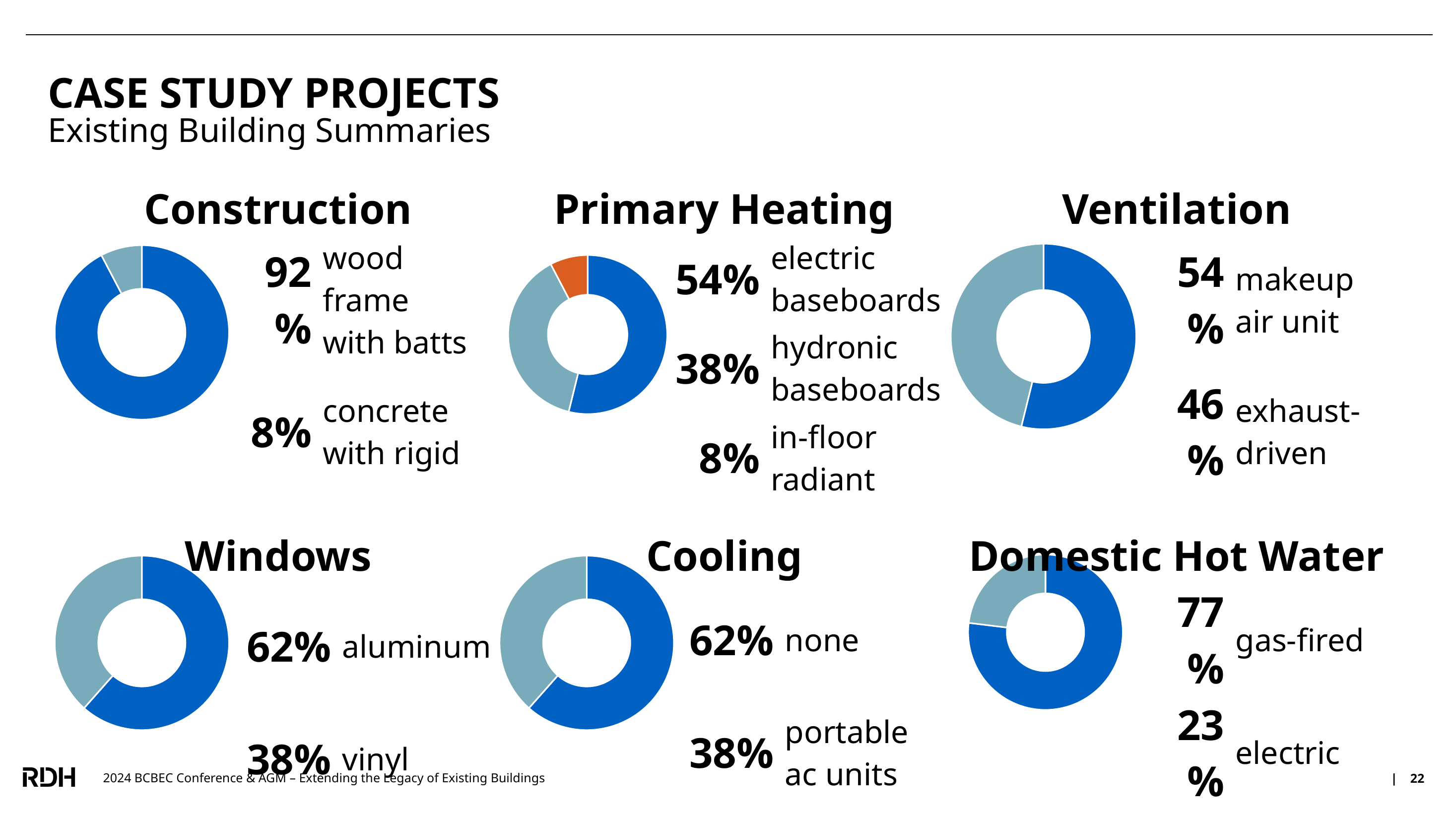
In the Domestic Hot Water chart, what is the difference between the gas-fired and electric shares? 54% In the Primary Heating chart, which heating type has the smallest share? in-floor radiant In the Windows chart, what share of projects have vinyl windows? 38% In the Cooling chart, what percentage of projects have no cooling? 62% In the Primary Heating chart, what percentage of projects use hydronic baseboards? 38% In the Construction chart, what share of projects are wood frame with batts? 92% In the Ventilation chart, which is larger: makeup air unit or exhaust-driven? makeup air unit How many donut charts are shown on the slide? 6 In the Ventilation chart, what is the difference between the makeup air unit share and the exhaust-driven share? 8% What kind of chart is used for the Construction summary? donut chart In the Primary Heating chart, what colour is the in-floor radiant slice? orange How many categories does the Primary Heating chart show? 3